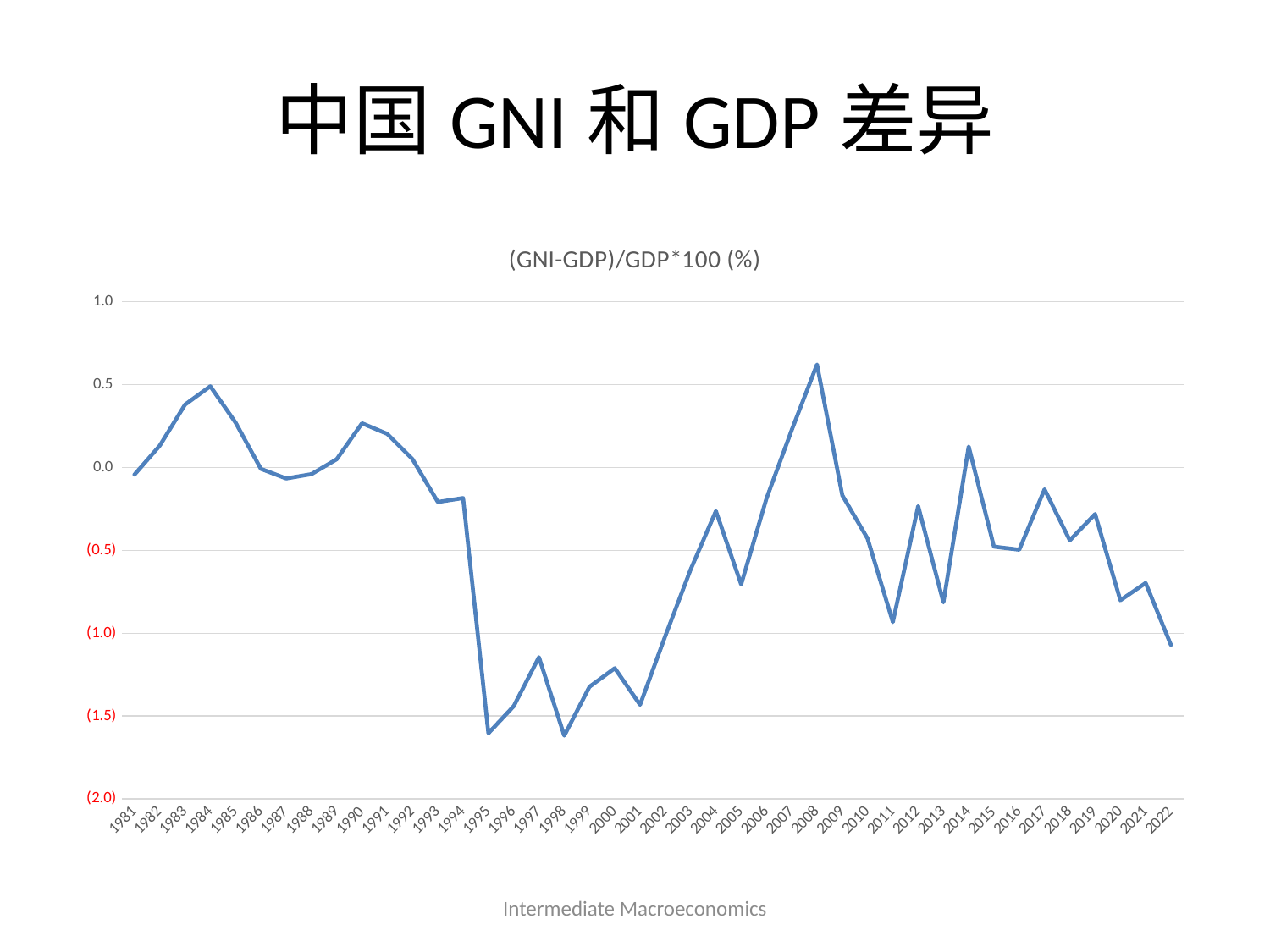
Is the value for 2008 greater or less than 0.5? greater Is the value for 2004 greater or less than (0.5)? greater Which year has the larger value, 1984 or 2008? 2008 Which year has the highest value of (GNI-GDP)/GDP*100? 2008 What is the title printed above the chart's plot area? (GNI-GDP)/GDP*100 (%) Is the value for 1984 greater or less than 0.0? greater What kind of chart is shown on the slide? line chart Does the value rise or fall from 2005 to 2008? rise Does the value rise or fall from 1994 to 1995? fall How many years are plotted along the x axis? 42